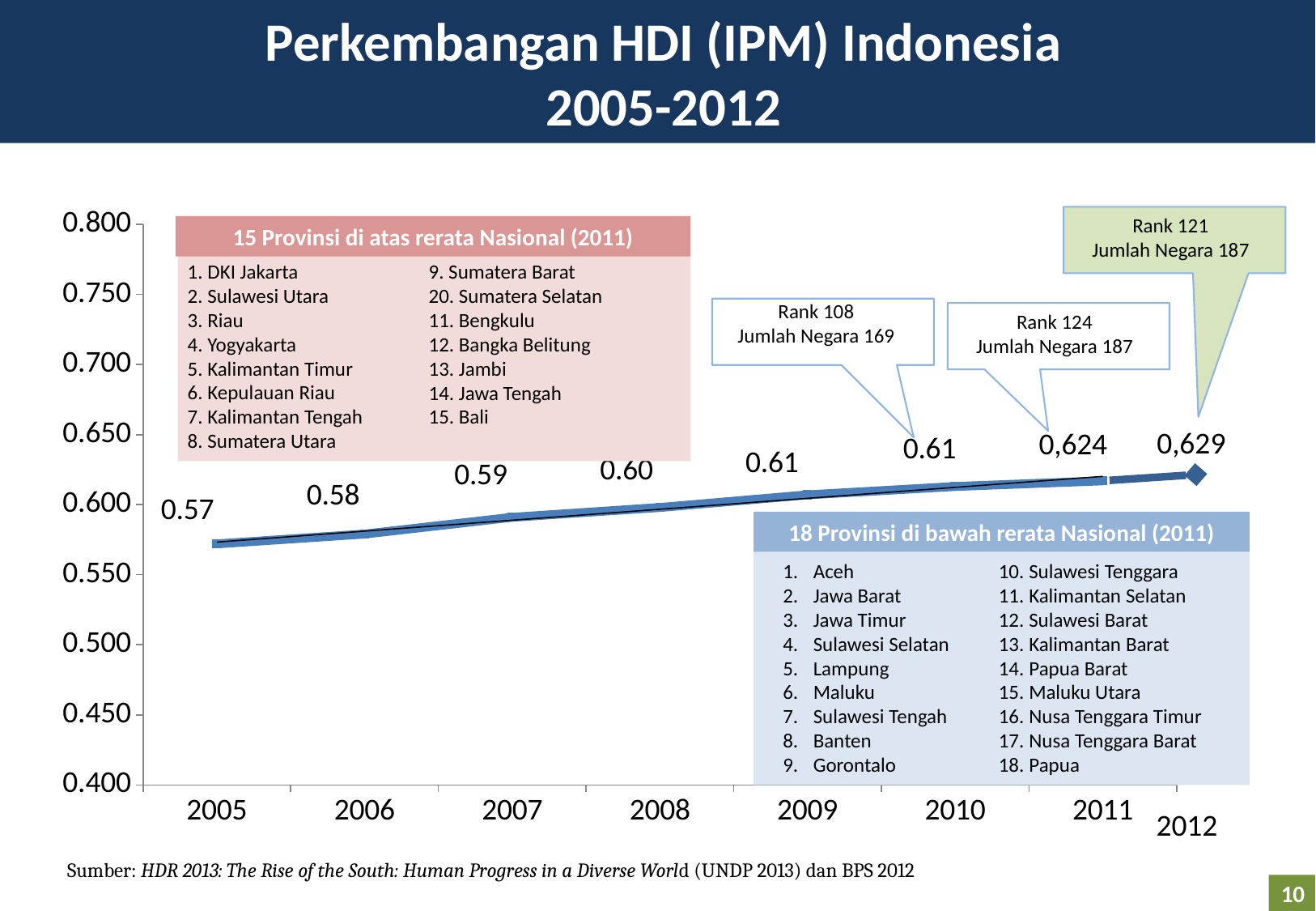
What is the HDI value shown for 2012? 0,629 Which year has the larger HDI value, 2006 or 2008? 2008 What is the HDI value shown for 2011? 0,624 How many years (data points) are plotted on the chart? 8 According to the callout for 2012, what is Indonesia's rank and out of how many countries? Rank 121 of 187 countries What is the HDI value shown for 2008? 0.60 Does the HDI value rise or fall from 2005 to 2012? Rise Which year has the lowest HDI value on the chart? 2005 What is the difference between the HDI values for 2009 and 2005? 0.04 Which year has the highest HDI value on the chart? 2012 What kind of chart is used to show the HDI development? Line chart What is the HDI value for Indonesia in 2005? 0.57